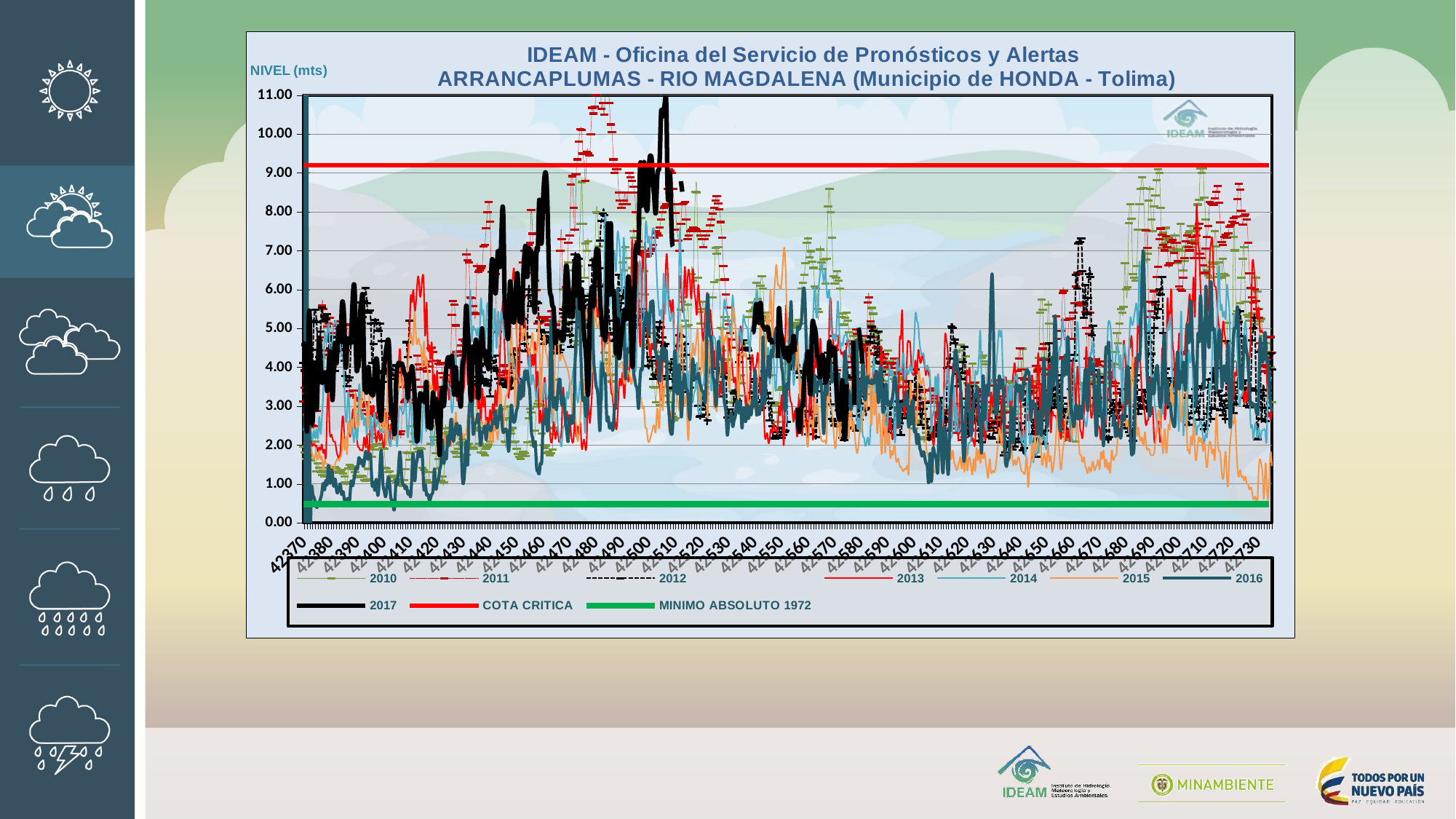
What is the label of the vertical axis of the chart? NIVEL (mts) Does the 2017 line ever rise above the COTA CRITICA line? Yes How many entries does the chart legend list? 10 What kind of chart is shown on the slide? Line chart What is the highest value shown on the vertical axis? 11.00 What is the last value shown on the horizontal axis? 42730 Which year series is the earliest listed in the legend? 2010 Is the COTA CRITICA line greater or less than 9.00? greater What is the first value shown on the horizontal axis? 42370 Which legend entry is drawn as the thick red horizontal line? COTA CRITICA Which year series is the latest listed in the legend? 2017 Is the MINIMO ABSOLUTO 1972 line greater or less than 1.00? less